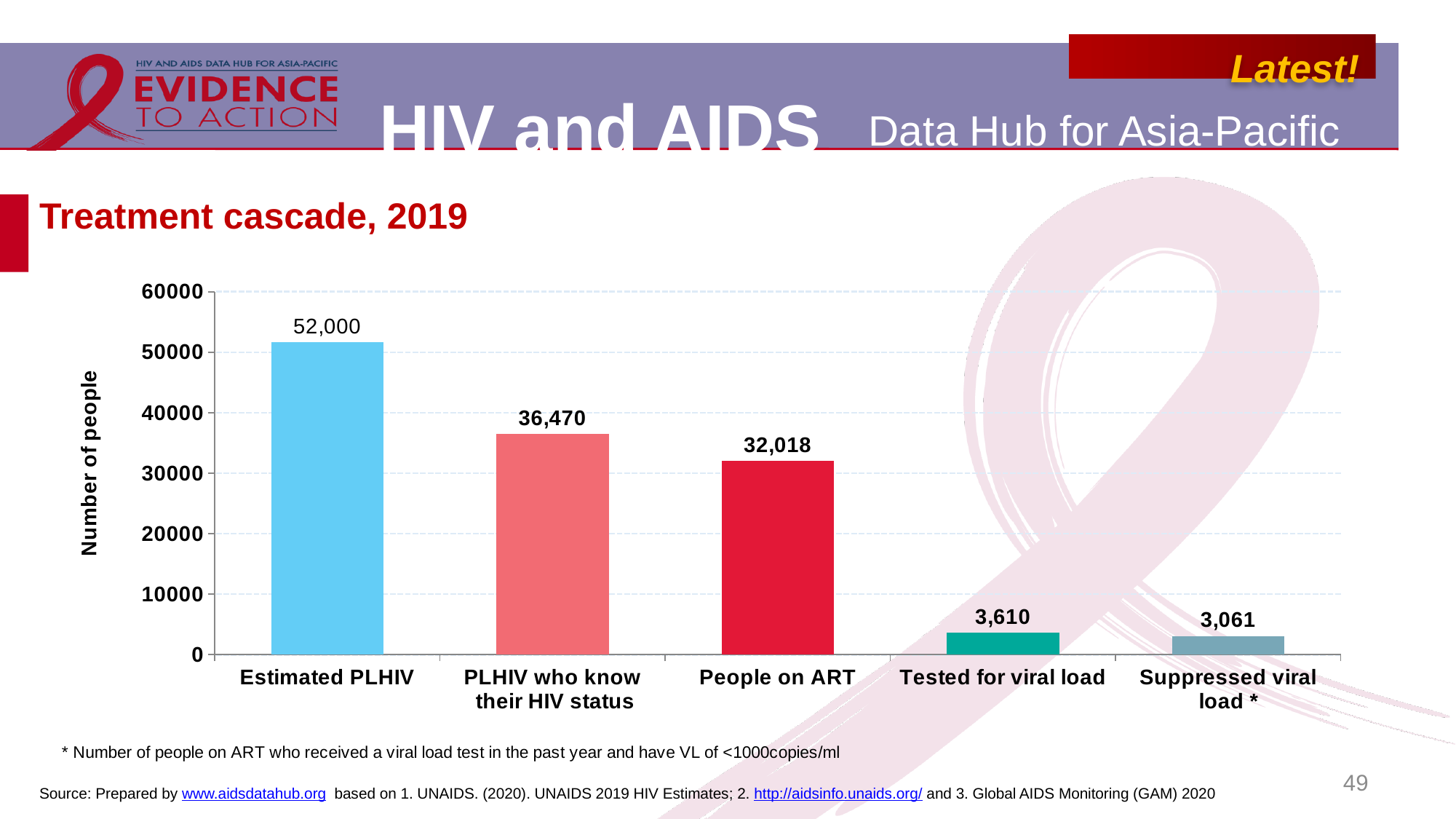
Which category has the lowest value? Suppressed viral load Do the values rise or fall from left to right across the categories? Fall What is the value for Estimated PLHIV? 52,000 What kind of chart is shown on the slide? Bar chart What is the value for Tested for viral load? 3,610 How many categories are shown on the chart? 5 Which is larger, PLHIV who know their HIV status or People on ART? PLHIV who know their HIV status Which category has the highest value? Estimated PLHIV What is the value for Suppressed viral load? 3,061 What is the difference between Estimated PLHIV and People on ART? 19,982 What is the value for People on ART? 32,018 What is the value for PLHIV who know their HIV status? 36,470